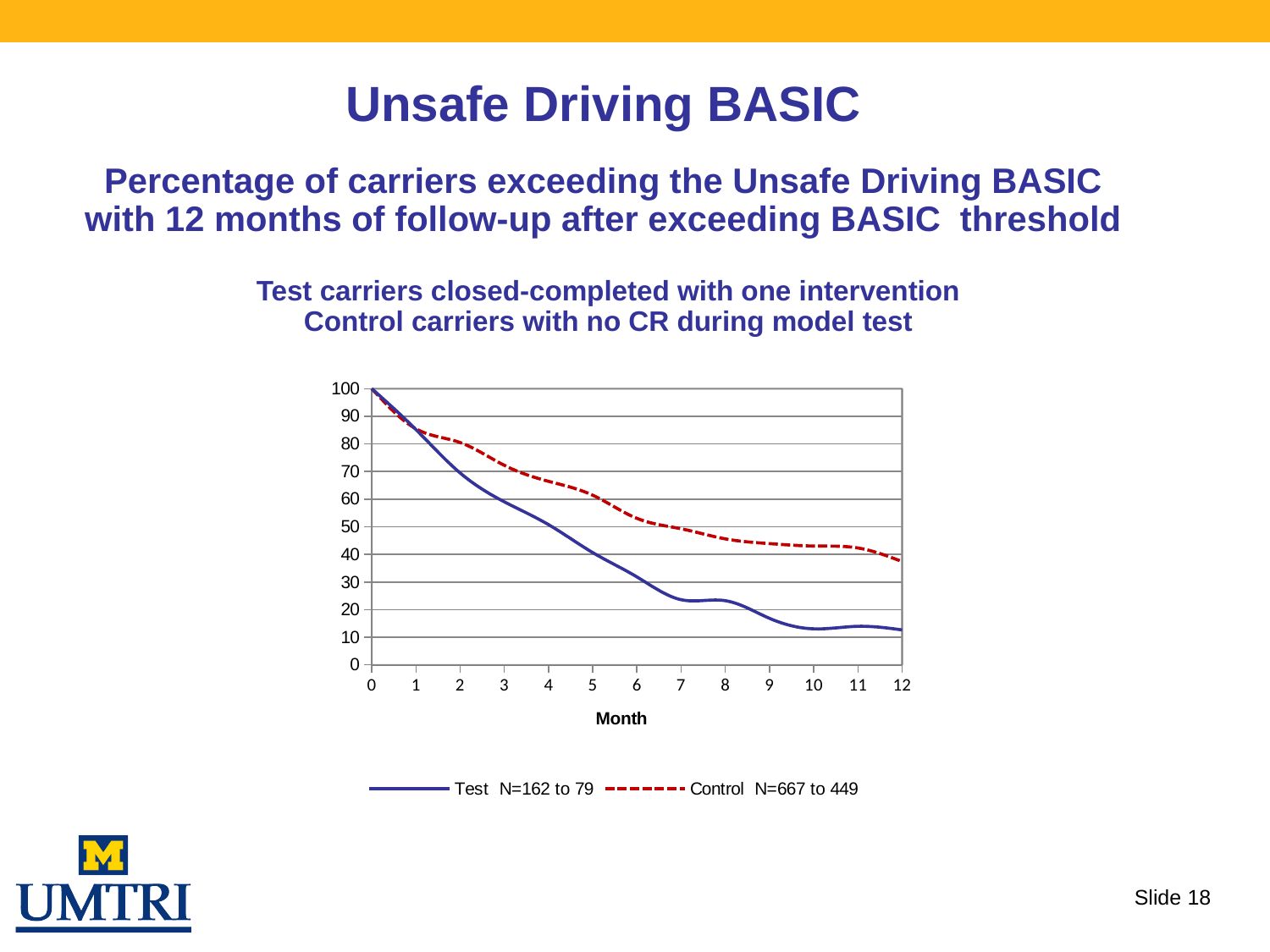
Is the value for the Control series at month 4 greater or less than 60? greater Is the value for the Test series at month 12 greater or less than 20? less What is the title of the x axis? Month What is the value of the Test series at month 0? 100 Is the value for the Control series at month 8 greater or less than 50? less At month 6, which series has the higher value, Test or Control? Control Does the Test series rise or fall as the month increases from 0 to 12? fall What is the legend label for the dashed line? Control N=667 to 449 What kind of chart is shown on the slide? line chart Does the Control series rise or fall as the month increases from 0 to 12? fall How many series does the chart legend list? 2